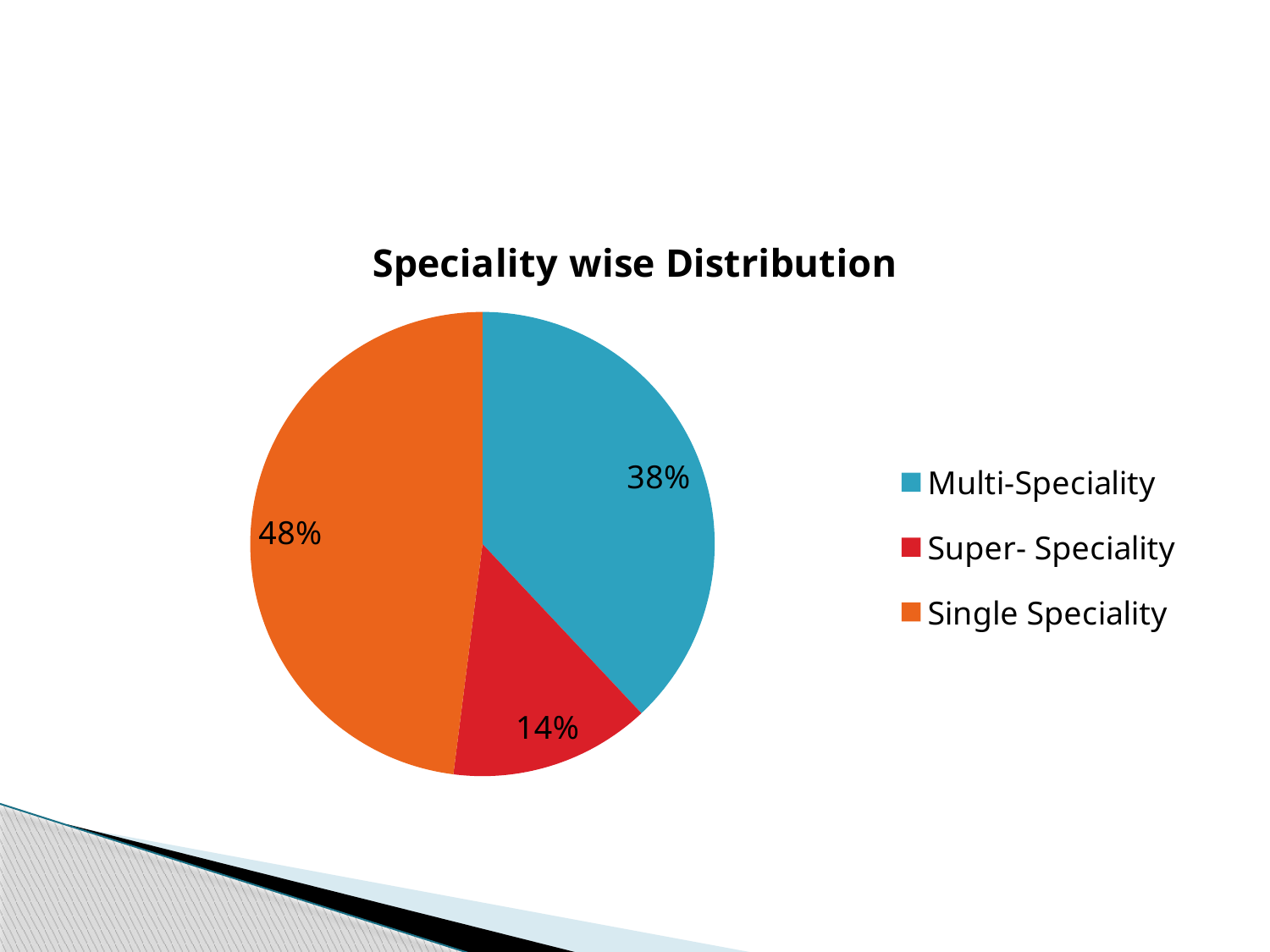
What is the difference in percentage points between Single Speciality and Multi-Speciality? 10 What is the difference in percentage points between Multi-Speciality and Super- Speciality? 24 What share of the pie does Super- Speciality have? 14% How many categories does the pie chart show? 3 Which category has the smallest slice of the pie? Super- Speciality What share of the pie does Single Speciality have? 48% What share of the pie does Multi-Speciality have? 38% What is the title of the chart? Speciality wise Distribution Which colour represents Single Speciality in the legend? orange What type of chart is shown on the slide? pie chart Which is larger, the Multi-Speciality slice or the Super- Speciality slice? Multi-Speciality Which category has the largest slice of the pie? Single Speciality